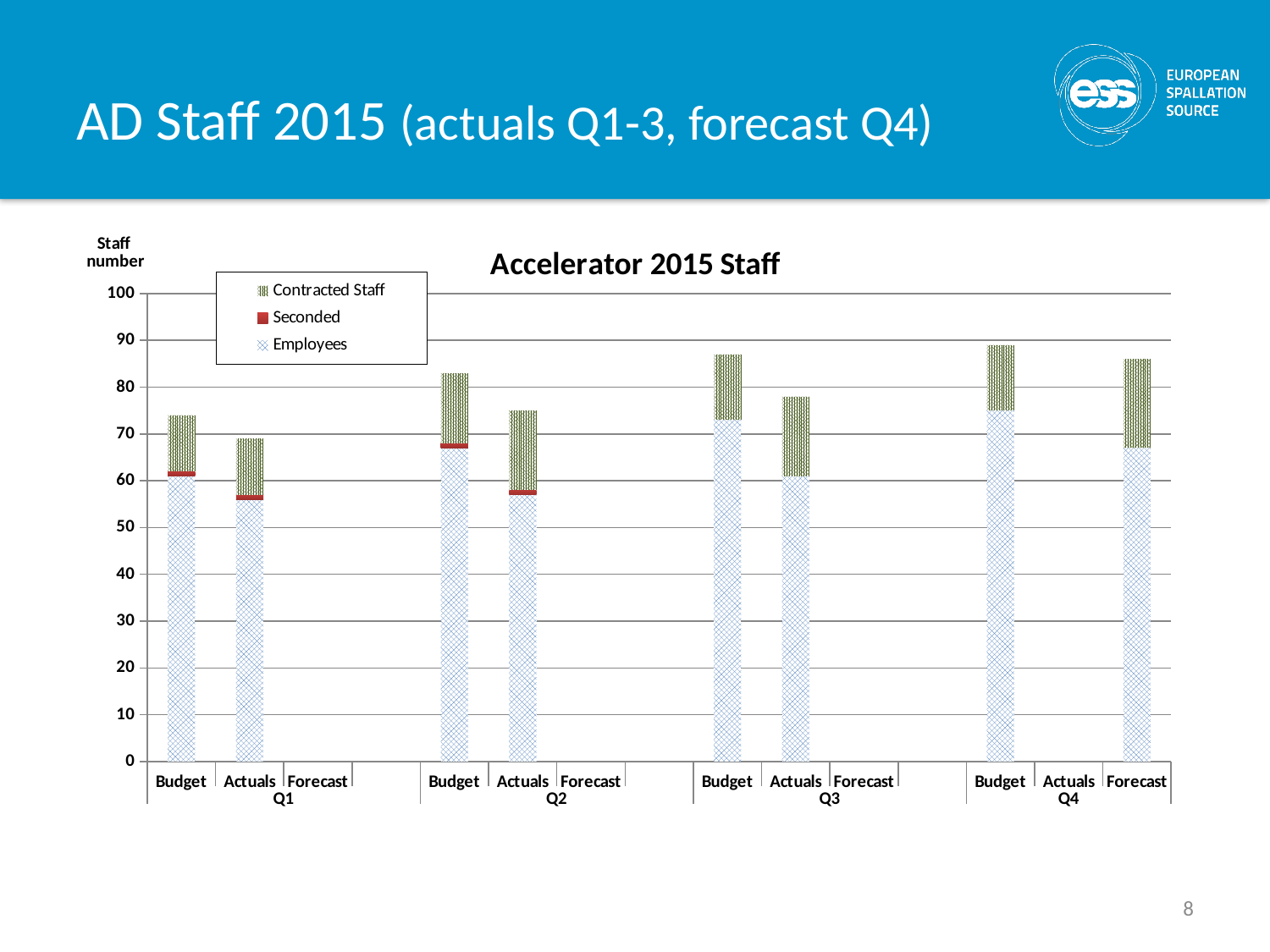
Is the total Budget bar for Q1 greater or less than 70? greater Which series is shown in red in the legend? Seconded How many series does the legend list? 3 How many quarters are shown along the x axis? 4 Which plotted bar has the lowest total staff number? Q1 Actuals In Q2, which total bar is larger, Budget or Actuals? Budget Is the total Budget bar for Q3 greater or less than 90? less What kind of chart is shown on the slide? Stacked bar chart Is the total Forecast bar for Q4 greater or less than 80? greater Do the Budget bar totals rise or fall from Q1 to Q4? rise What is the title of the chart? Accelerator 2015 Staff